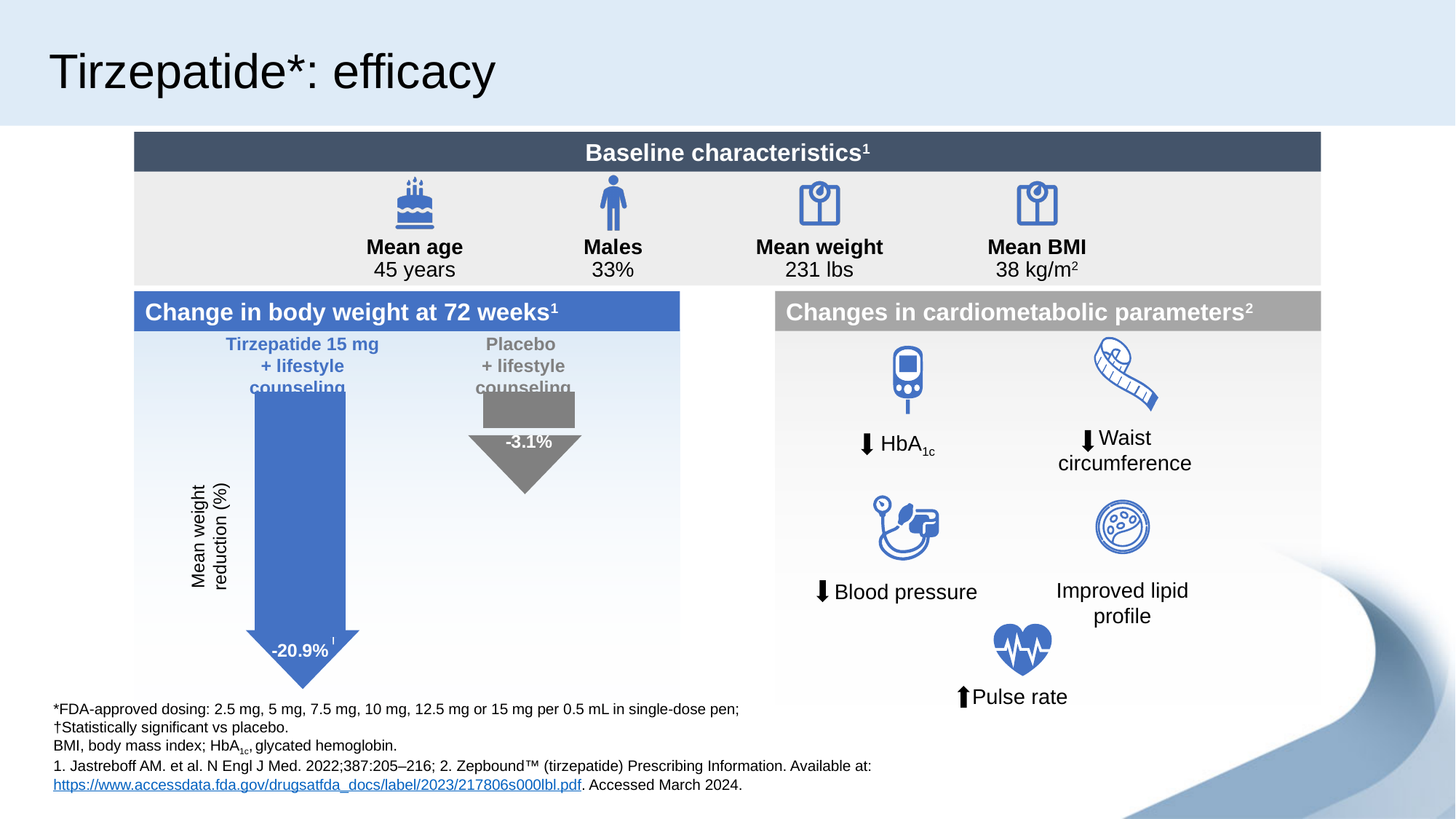
How many treatment groups are shown in the 'Change in body weight at 72 weeks' chart? 2 In the 'Change in body weight at 72 weeks' chart, what is the mean weight reduction for Placebo + lifestyle counseling? -3.1% In the 'Change in body weight at 72 weeks' chart, what is the mean weight reduction for Tirzepatide 15 mg + lifestyle counseling? -20.9% In the 'Change in body weight at 72 weeks' chart, what colour is the arrow for Tirzepatide 15 mg + lifestyle counseling? Blue In the 'Change in body weight at 72 weeks' chart, by how many percentage points does the weight reduction for Tirzepatide 15 mg exceed that of placebo? 17.8 percentage points In the 'Change in body weight at 72 weeks' chart, which group's value is marked with a dagger (†) indicating statistical significance vs placebo? Tirzepatide 15 mg + lifestyle counseling In the 'Change in body weight at 72 weeks' chart, is the weight reduction greater for Tirzepatide 15 mg + lifestyle counseling or for Placebo + lifestyle counseling? Tirzepatide 15 mg + lifestyle counseling What is the label of the vertical axis in the 'Change in body weight at 72 weeks' chart? Mean weight reduction (%) In the 'Change in body weight at 72 weeks' chart, which group shows the smaller mean weight reduction? Placebo + lifestyle counseling In the 'Change in body weight at 72 weeks' chart, which group shows the larger mean weight reduction? Tirzepatide 15 mg + lifestyle counseling